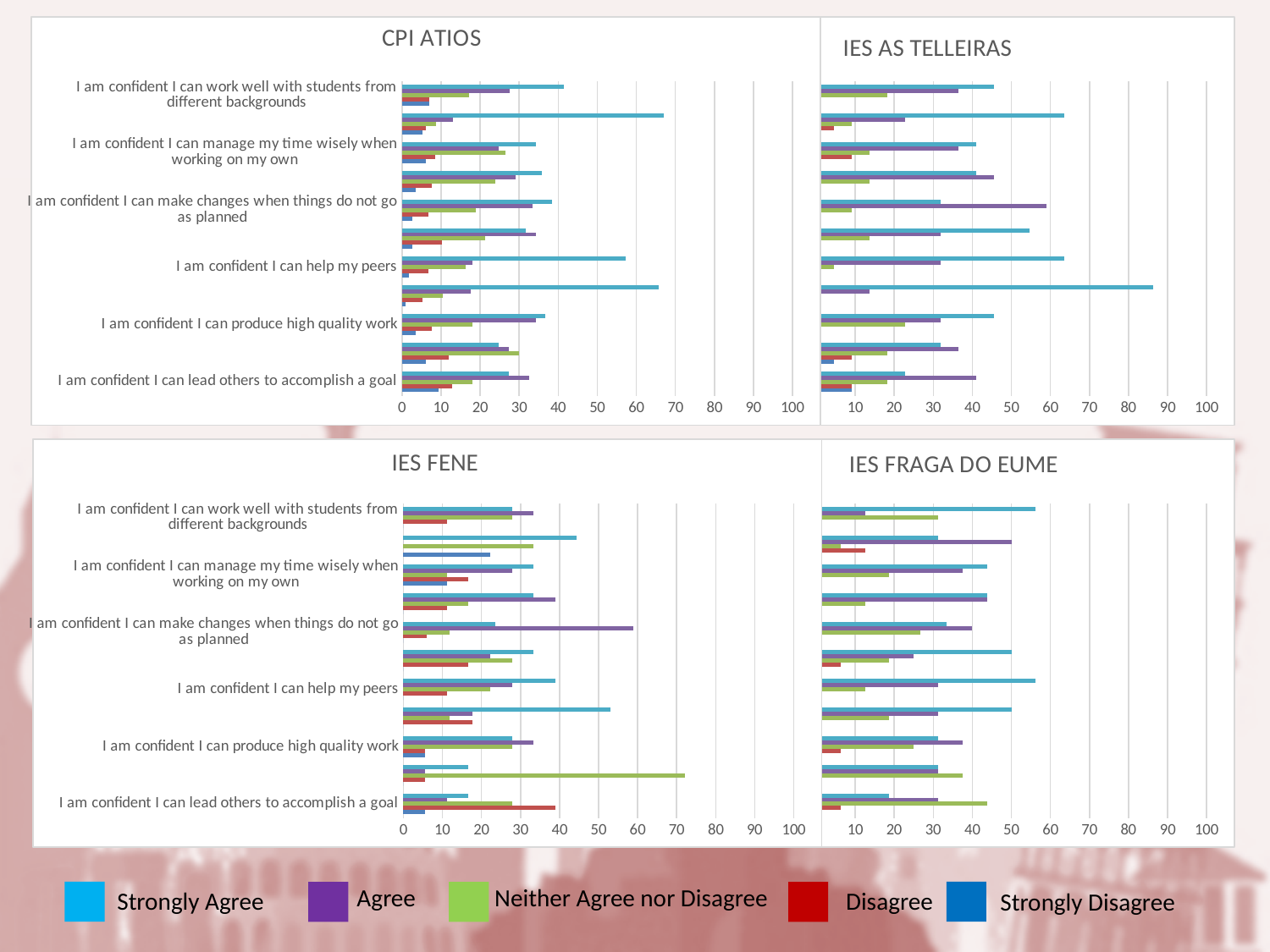
How many series does the legend at the bottom of the slide list? 5 Which colour represents Disagree in the legend? Red How many charts are shown on the slide? 4 In the IES AS TELLEIRAS chart, is the longest Strongly Agree bar greater or less than 80? greater In the IES FRAGA DO EUME chart, is the Strongly Agree value for 'I am confident I can work well with students from different backgrounds' greater or less than 50? greater In the IES FENE chart, is the Disagree value for 'I am confident I can lead others to accomplish a goal' greater or less than 30? greater What is the title of the chart in the bottom-right of the slide? IES FRAGA DO EUME In the IES FENE chart, which series has the highest value for 'I am confident I can lead others to accomplish a goal'? Disagree In the IES FRAGA DO EUME chart, for 'I am confident I can work well with students from different backgrounds', which is larger: Strongly Agree or Agree? Strongly Agree What kind of chart is the CPI ATIOS chart? Bar chart